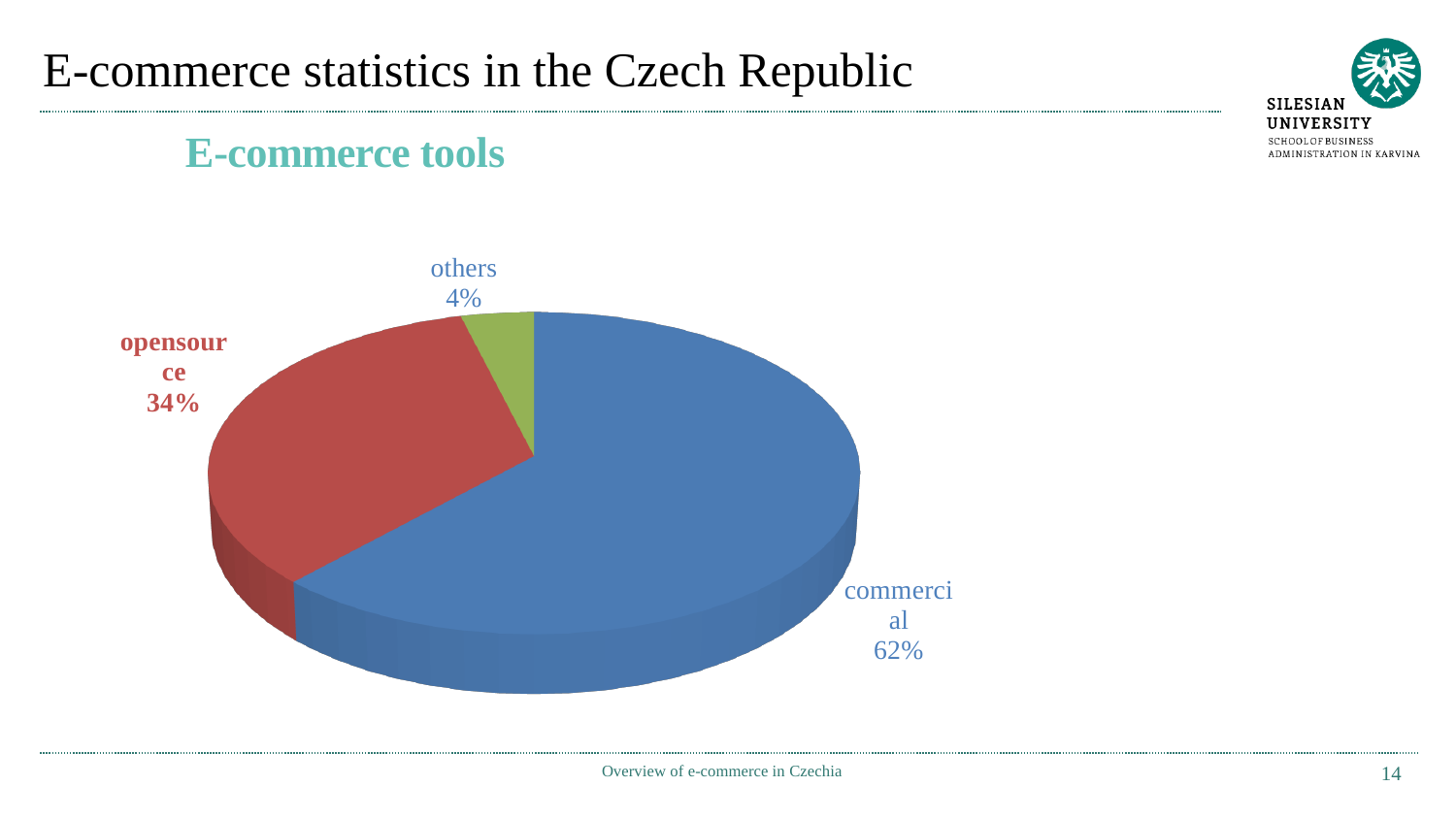
What share of the pie does the opensource slice represent? 34% Which category has the largest share of the pie? commercial What kind of chart is shown on the slide? pie chart How many slices does the pie chart have? 3 What is the difference in percentage points between the opensource and others shares? 30 What is the difference in percentage points between the commercial and opensource shares? 28 What share of the pie does the others slice represent? 4% Which is larger, the commercial share or the opensource share? commercial What is the title of the chart? E-commerce tools Which category has the smallest share of the pie? others What share of the pie does the commercial slice represent? 62% What colour is the opensource slice? red